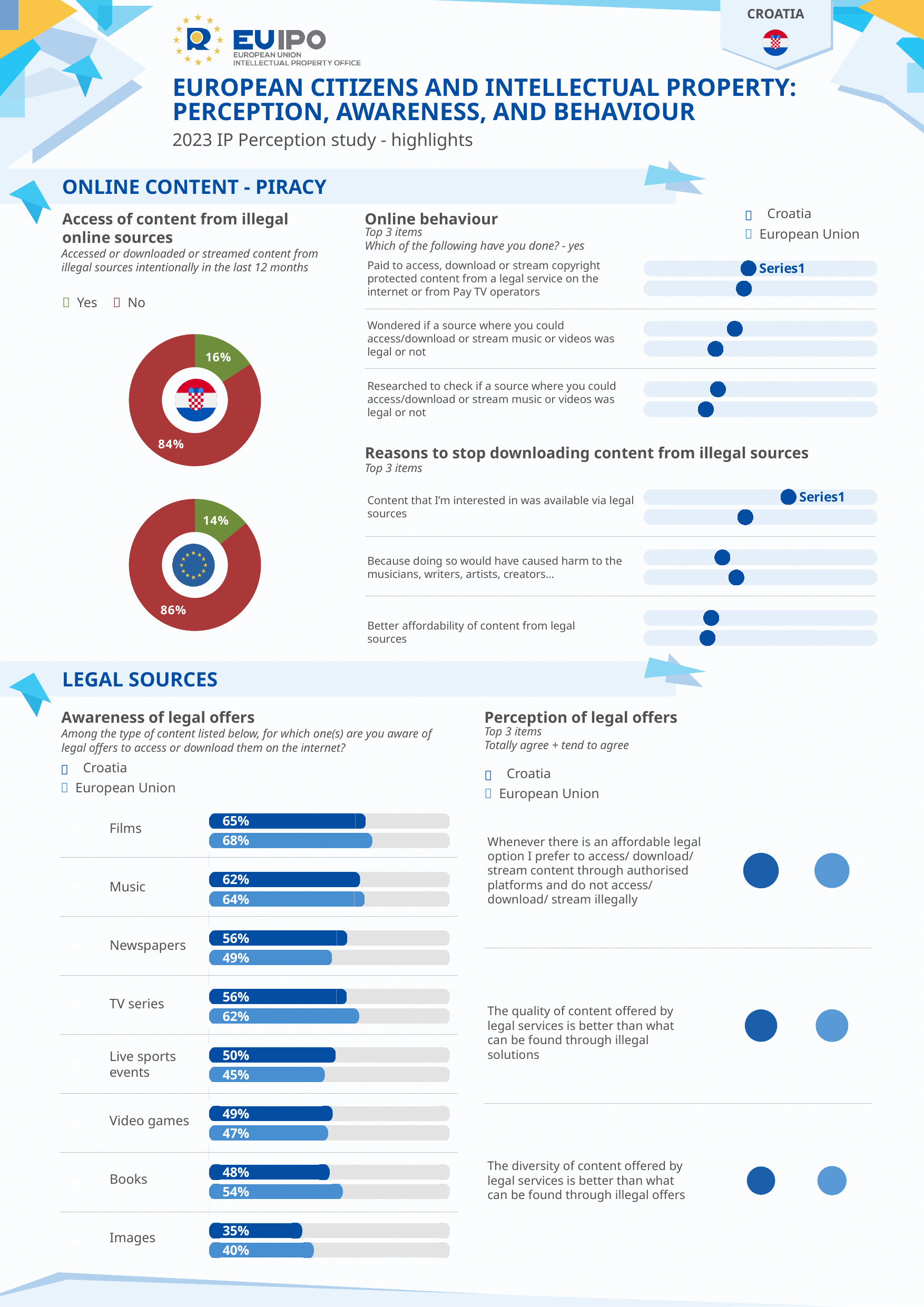
In the 'Access of content from illegal online sources' donut chart for the European Union, what percentage answered No? 86% In the 'Access of content from illegal online sources' donut chart for Croatia, what percentage answered Yes? 16% In the 'Awareness of legal offers' bar chart, which is larger for Live sports events: the Croatia value or the European Union value? Croatia In the 'Awareness of legal offers' bar chart, what is the value for the European Union for Books? 54% How many content types are listed in the 'Awareness of legal offers' bar chart? 8 In the 'Awareness of legal offers' bar chart, which content type has the lowest value for Croatia? Images In the 'Awareness of legal offers' bar chart, what is the difference between the Croatia and European Union values for Newspapers? 7 percentage points How many series does the legend of the 'Awareness of legal offers' chart list? 2 In the 'Access of content from illegal online sources' donut chart for Croatia, what is the difference between the No and Yes shares? 68 percentage points In the 'Awareness of legal offers' bar chart, which content type has the highest value for the European Union? Films What kind of chart is used for 'Access of content from illegal online sources'? Donut (pie) chart In the 'Awareness of legal offers' bar chart, what is the value for Croatia for Films? 65%